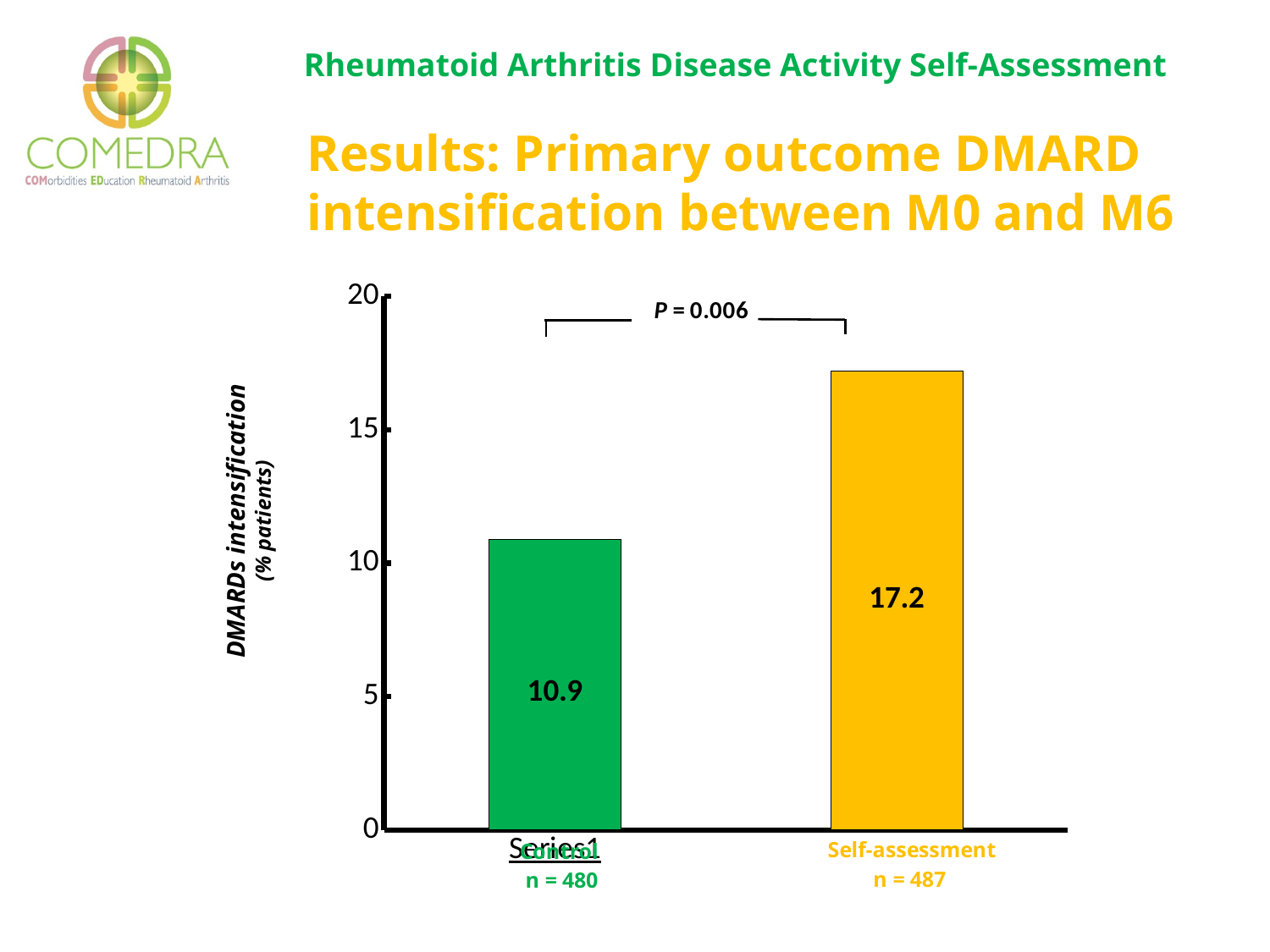
What P value is shown above the bars? P = 0.006 Is the value for Control greater or less than 10? greater What is the value for the Control group? 10.9 How many bars are shown in the chart? 2 Which group has the higher DMARDs intensification? Self-assessment What type of chart is shown? Bar chart Is the value for Control larger than the value for Self-assessment? No Which group has the lower DMARDs intensification? Control What is the value for the Self-assessment group? 17.2 What is the y-axis label of the chart? DMARDs intensification (% patients) Is the value for Self-assessment greater or less than 15? greater What is the difference between the Self-assessment and Control values? 6.3